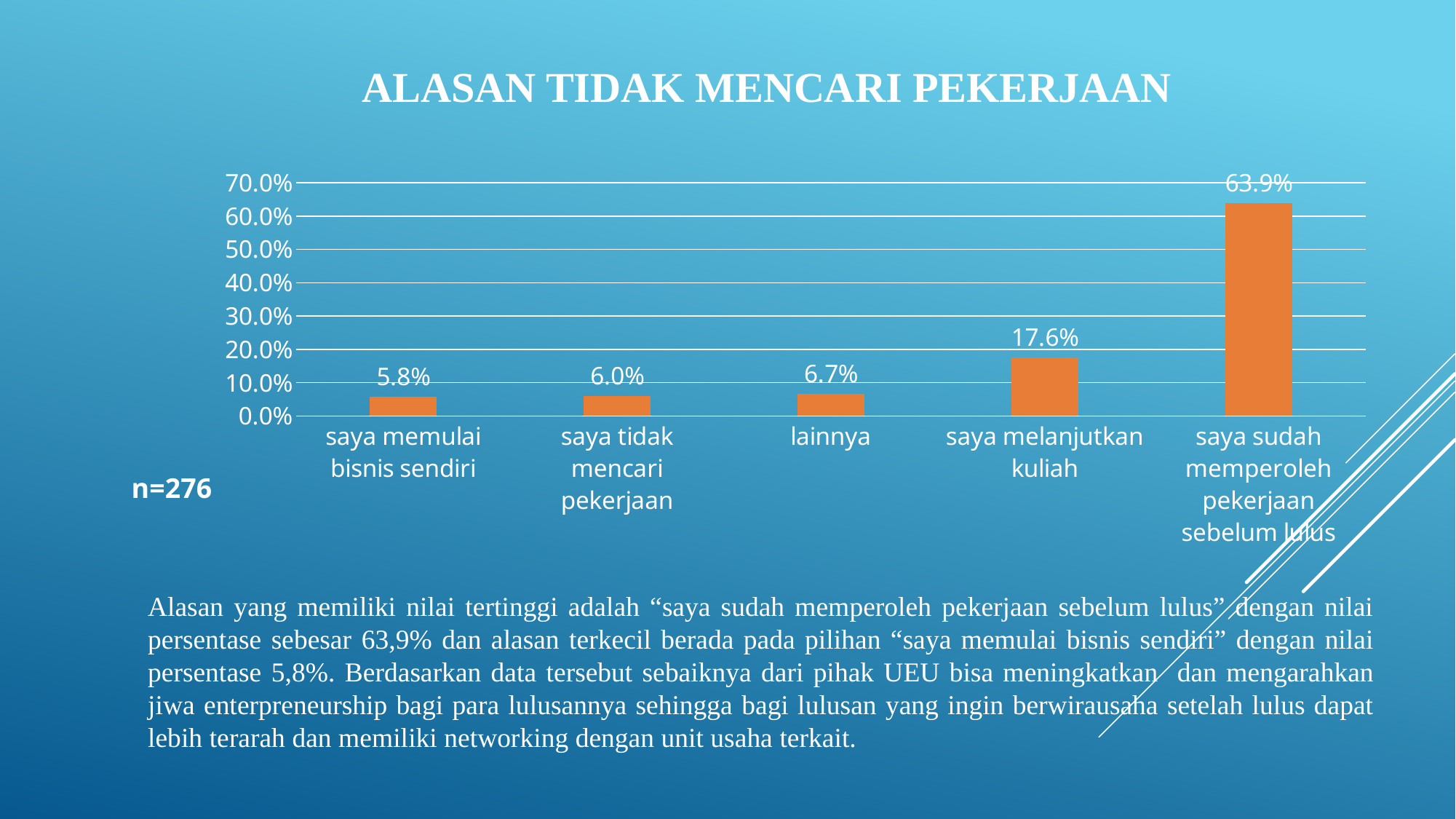
How many categories are shown on the x axis? 5 What is the title of the chart? ALASAN TIDAK MENCARI PEKERJAAN What kind of chart is shown on the slide? bar chart What is the value for "lainnya"? 6.7% Which category has the lowest value? saya memulai bisnis sendiri Which is larger, the value for "lainnya" or the value for "saya tidak mencari pekerjaan"? lainnya What is the difference between the values for "saya sudah memperoleh pekerjaan sebelum lulus" and "saya melanjutkan kuliah"? 46.3% What is the value for "saya melanjutkan kuliah"? 17.6% What is the value for "saya sudah memperoleh pekerjaan sebelum lulus"? 63.9% Which category has the highest value? saya sudah memperoleh pekerjaan sebelum lulus Is the value for "saya melanjutkan kuliah" greater or less than 20.0%? less What is the value for "saya memulai bisnis sendiri"? 5.8%